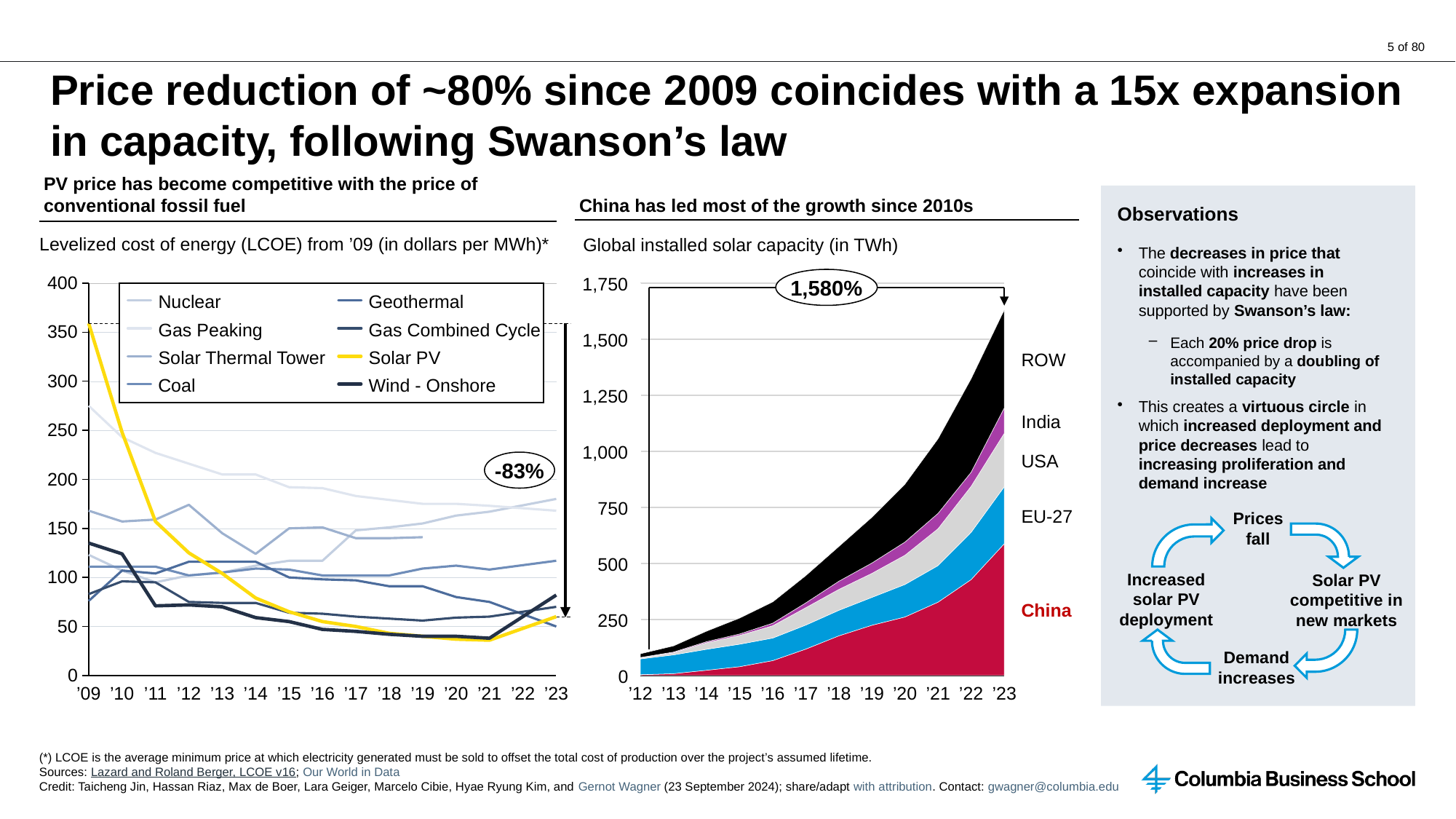
In the right chart (Global installed solar capacity), how many regions are stacked? 5 In the left chart (LCOE), does the Solar PV line rise or fall from '09 to '21? Fall In the left chart (LCOE), is the value for Solar PV in '21 greater or less than 50? less In the left chart (LCOE), is the value for Solar PV in '09 greater or less than 300? greater In the right chart (Global installed solar capacity), is the total installed capacity in '23 greater or less than 1,500? greater What kind of chart is the left chart, 'Levelized cost of energy (LCOE) from '09 (in dollars per MWh)'? Line chart In the right chart (Global installed solar capacity), how many years are shown on the x axis? 12 In the left chart (LCOE), which series has the highest value in '09? Solar PV In the right chart (Global installed solar capacity), which region has the largest installed capacity in '23? China In the left chart (LCOE), how many years are shown on the x axis? 15 In the left chart (LCOE), how many series does the legend list? 8 What kind of chart is the right chart, 'Global installed solar capacity (in TWh)'? Stacked area chart